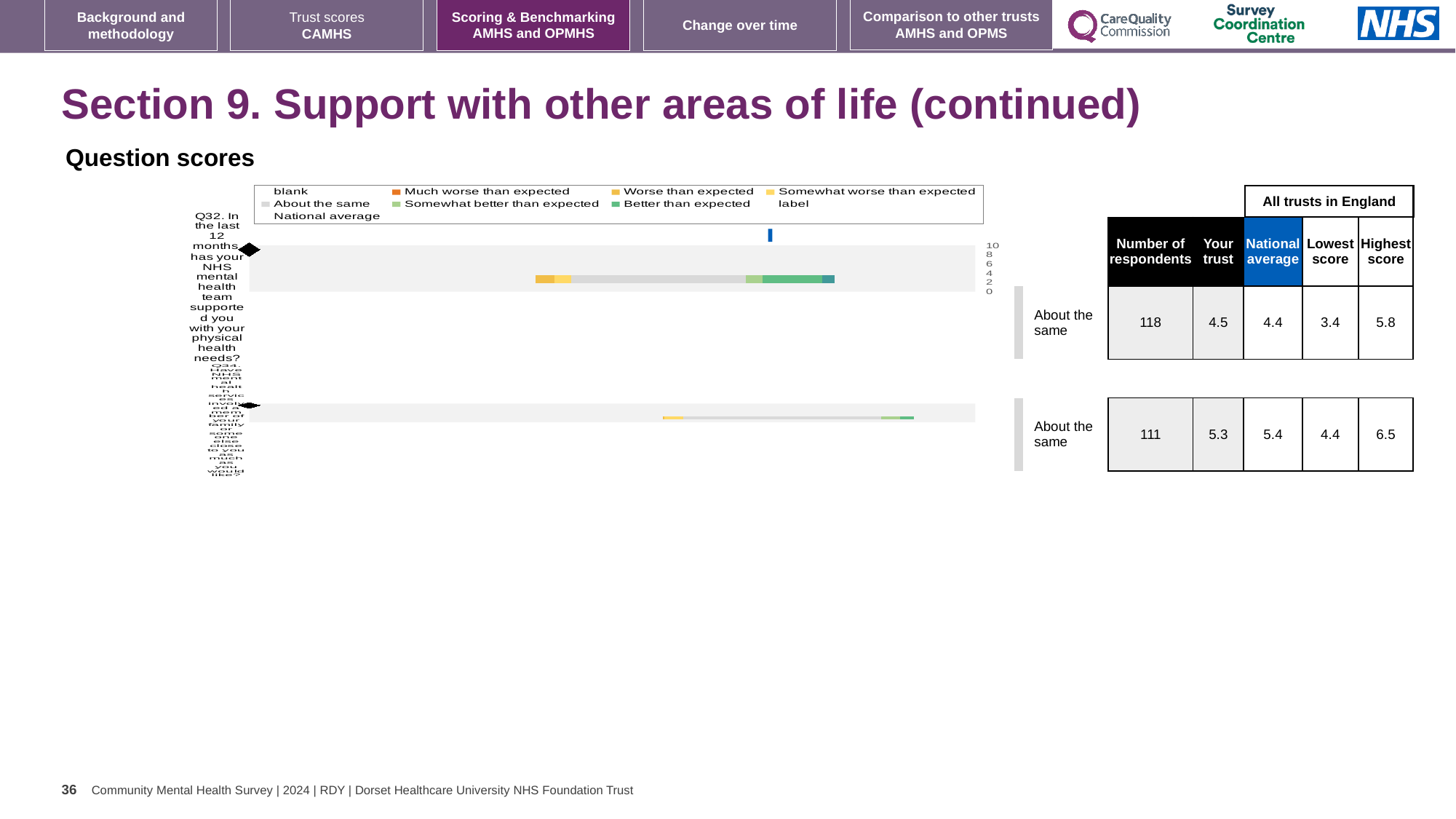
What benchmark category is given for both Q32 and Q34 next to the chart? About the same What is the difference between the highest and lowest score for Q32 in the table? 2.4 What is the 'Your trust' score for Q32 in the table beside the chart? 4.5 Which legend entry is shown in grey in the chart? About the same What is the number of respondents for Q32 in the table beside the chart? 118 What is the lowest score for Q32 in the table beside the chart? 3.4 What kind of chart is shown under 'Question scores'? bar chart What is the highest score for Q34 in the table beside the chart? 6.5 How many questions (bars) are plotted in the chart? 2 What is the national average for Q34 in the table beside the chart? 5.4 Which question has the larger 'Your trust' score, Q32 or Q34? Q34 How many entries does the chart legend list? 9